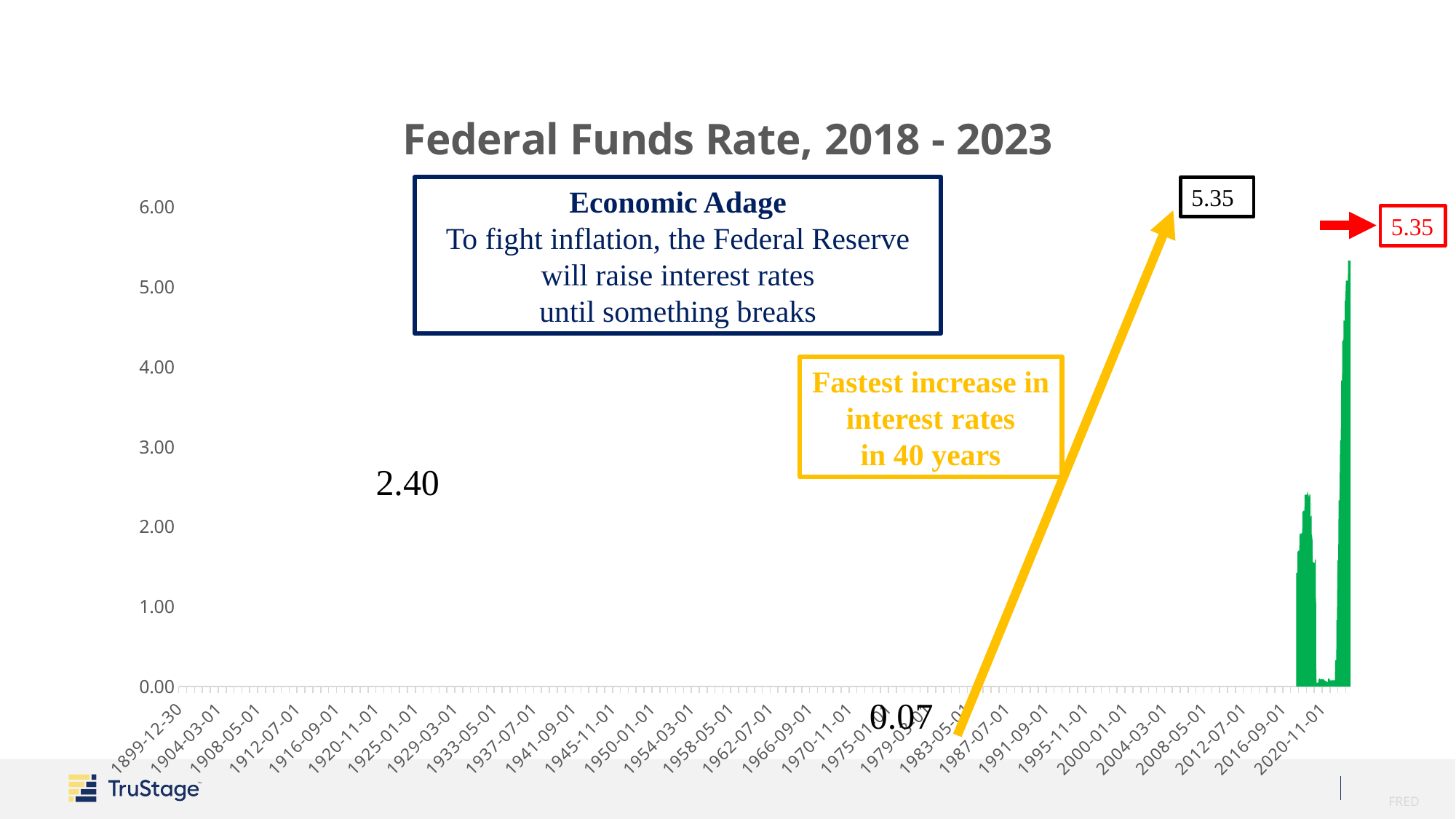
Is the most recent peak of the federal funds rate greater or less than 5.00? greater What is the peak value of the federal funds rate labeled on the chart? 5.35 Is the earlier peak of the federal funds rate greater or less than 3.00? less What is the title of the chart? Federal Funds Rate, 2018 - 2023 What kind of chart is used to show the federal funds rate? Area chart What is the lowest value labeled on the chart? 0.07 What is the difference between the labeled high of 5.35 and the labeled low of 0.07? 5.28 What colour is the plotted federal funds rate series? Green What is the difference between the labeled peak of 5.35 and the earlier peak of 2.40? 2.95 What value is labeled for the earlier, smaller peak in the federal funds rate? 2.40 Which labeled value is larger, the earlier peak or the most recent peak? The most recent peak (5.35) Does the federal funds rate rise or fall from its 2020 low to the end of the series? rise